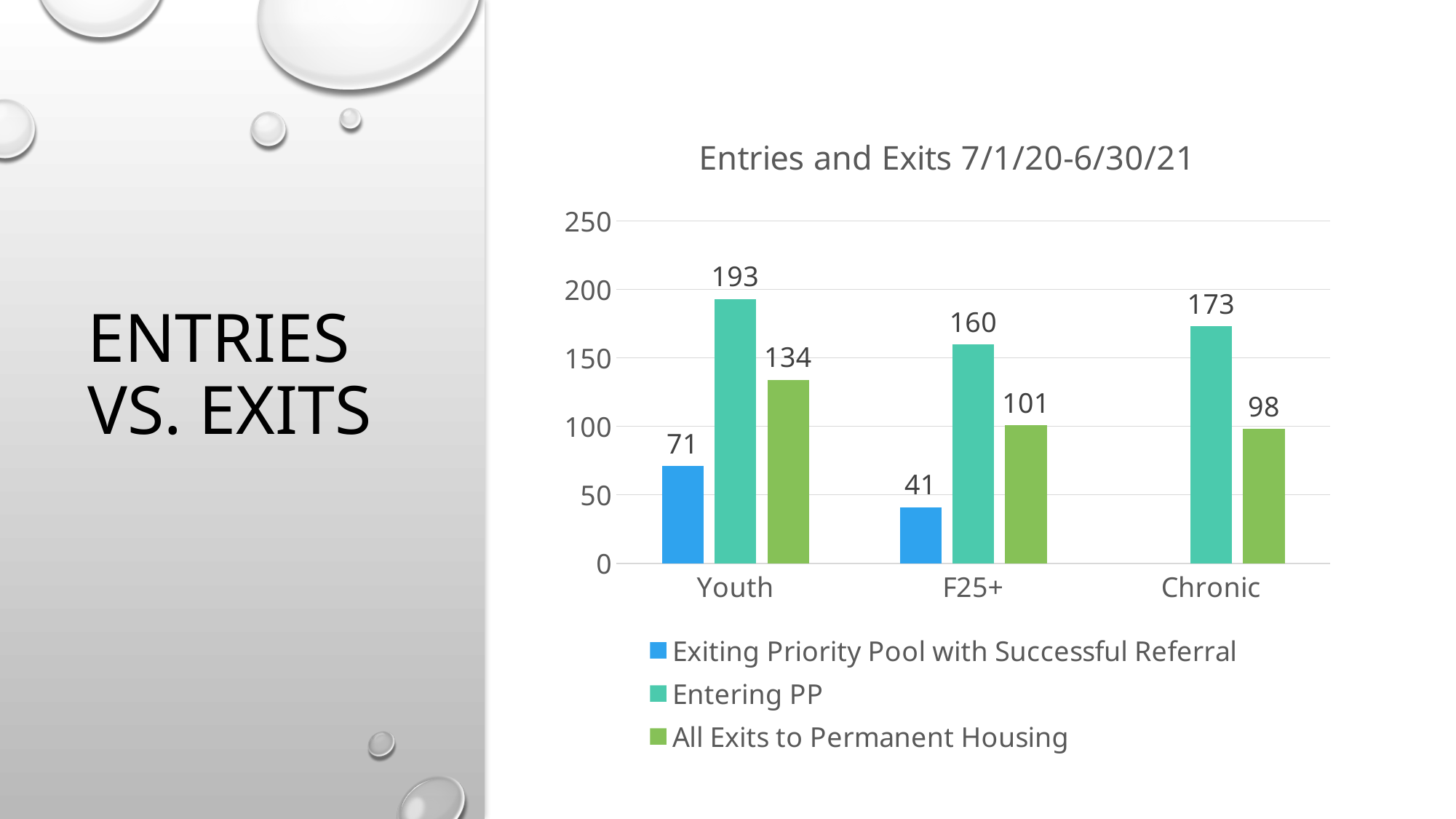
How many categories are shown on the x axis? 3 How many series does the legend list? 3 What is the value for Entering PP in the Youth category? 193 What is the value for Exiting Priority Pool with Successful Referral in the F25+ category? 41 What kind of chart is shown on the slide? Bar chart What is the difference between Entering PP and All Exits to Permanent Housing in the F25+ category? 59 Which category has the highest value for Entering PP? Youth Which category has the lowest value for All Exits to Permanent Housing? Chronic What is the value for All Exits to Permanent Housing in the Chronic category? 98 Which category has no bar for Exiting Priority Pool with Successful Referral? Chronic Which is larger: Entering PP for Chronic or Entering PP for F25+? Entering PP for Chronic What is the title of the chart? Entries and Exits 7/1/20-6/30/21